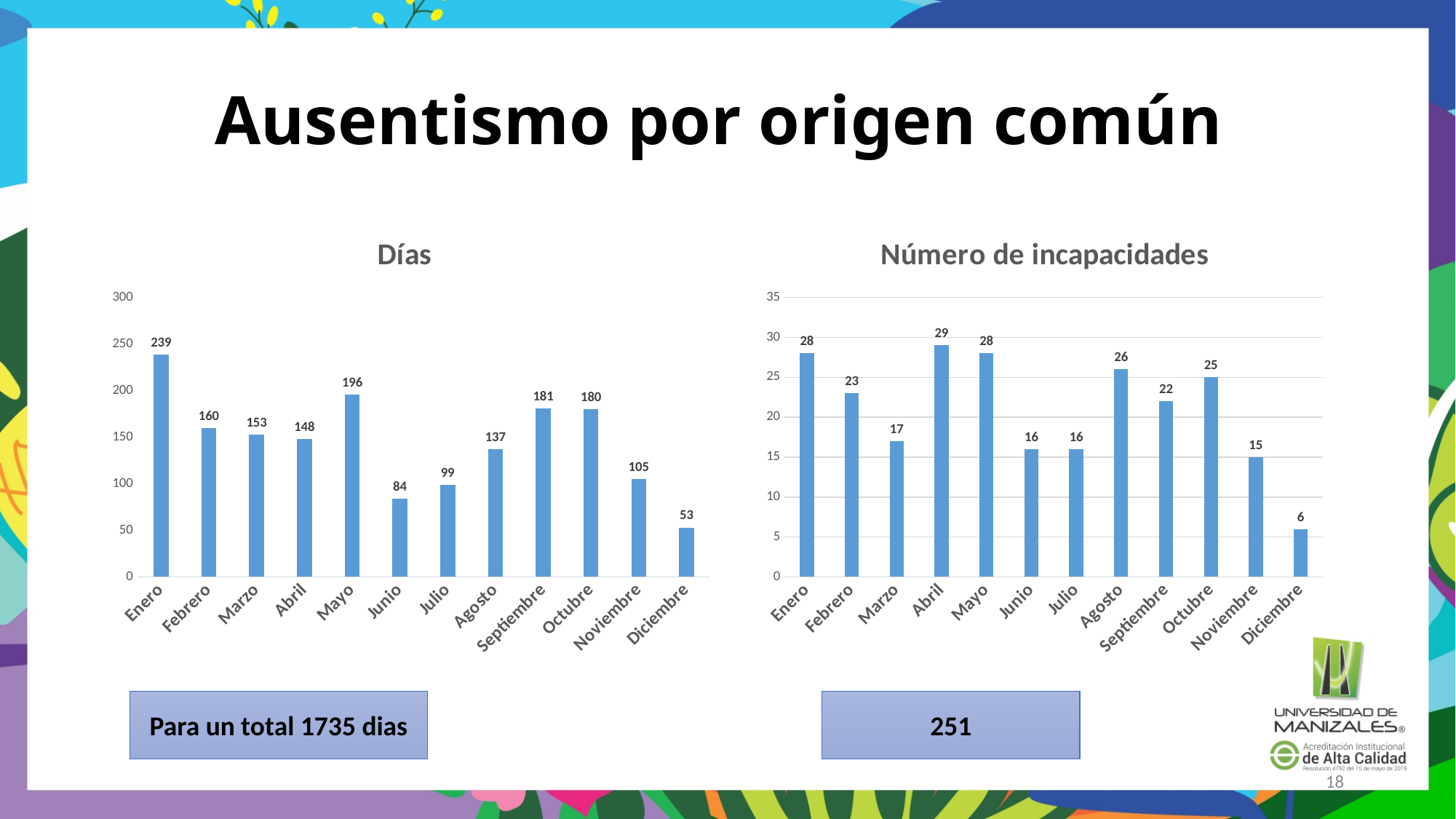
In the 'Número de incapacidades' chart, what is the value for Agosto? 26 In the 'Número de incapacidades' chart, do the values rise or fall from Octubre to Diciembre? Fall In the 'Número de incapacidades' chart, which month has the highest value? Abril In the 'Días' chart, how many months are shown on the x axis? 12 What is the title of the chart on the right side of the slide? Número de incapacidades In the 'Número de incapacidades' chart, is the value for Marzo greater or less than 20? less In the 'Días' chart, which month has the lowest value? Diciembre In the 'Días' chart, what is the difference between Mayo and Junio? 112 In the 'Días' chart, what is the value for Enero? 239 In the 'Número de incapacidades' chart, what is the difference between Octubre and Noviembre? 10 What kind of chart is the 'Días' chart? Bar chart In the 'Días' chart, which is larger, Septiembre or Octubre? Septiembre